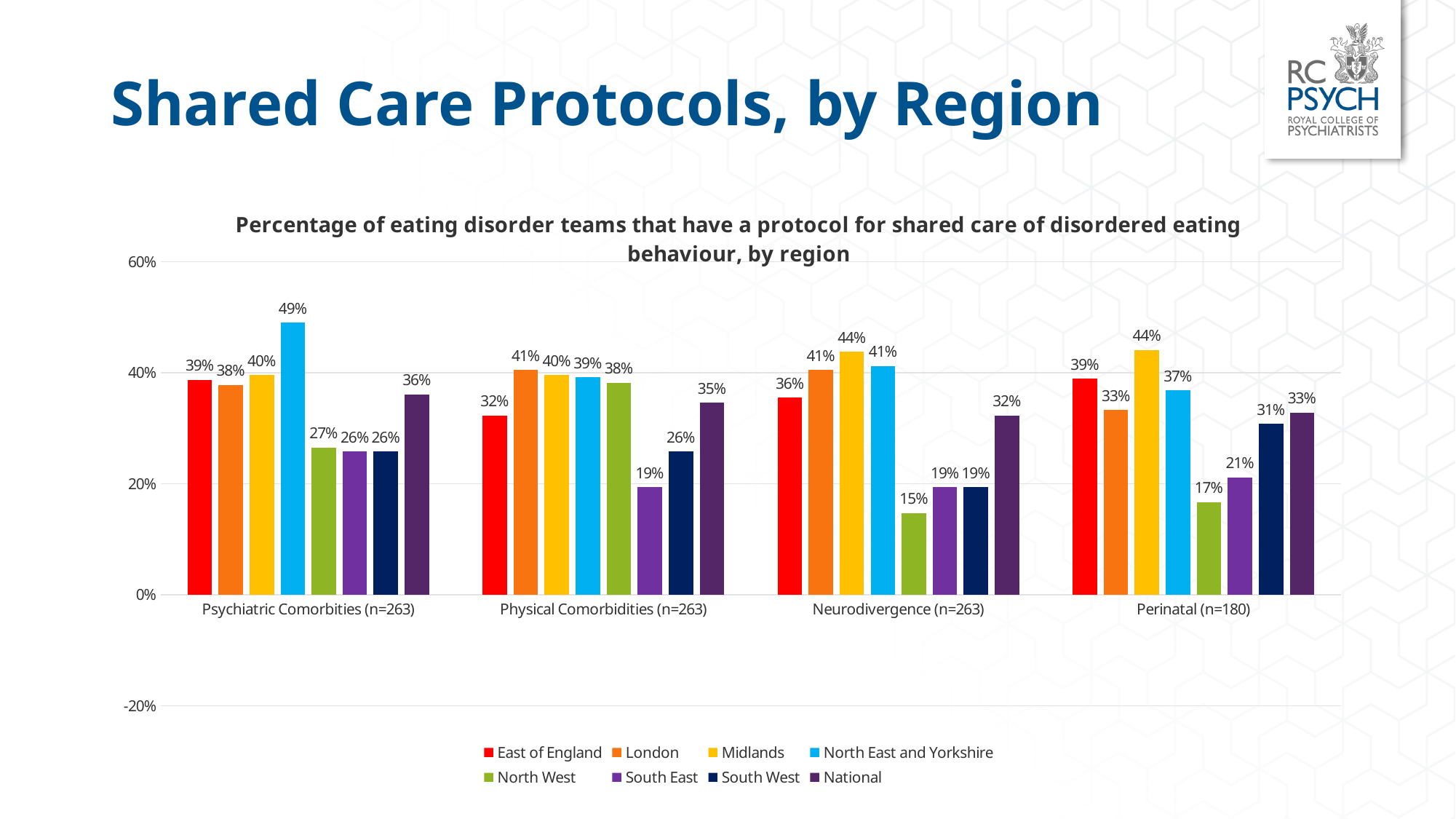
What is the National value for Neurodivergence (n=263)? 32% Which region has the highest value in the Neurodivergence (n=263) category? Midlands How many series does the legend list? 8 What is the value for North West in the Perinatal (n=180) category? 17% Which region has the lowest value in the Physical Comorbidities (n=263) category? South East Which is larger for Physical Comorbidities (n=263): East of England or London? London Which colour represents the National series in the chart? Dark purple Is the value for North East and Yorkshire in Psychiatric Comorbities (n=263) greater or less than 40%? greater What kind of chart is shown on the slide? Bar chart How many categories are shown on the x axis? 4 What is the value for North East and Yorkshire in the Psychiatric Comorbities (n=263) category? 49% What is the difference between the Midlands and North West values for Perinatal (n=180)? 27%